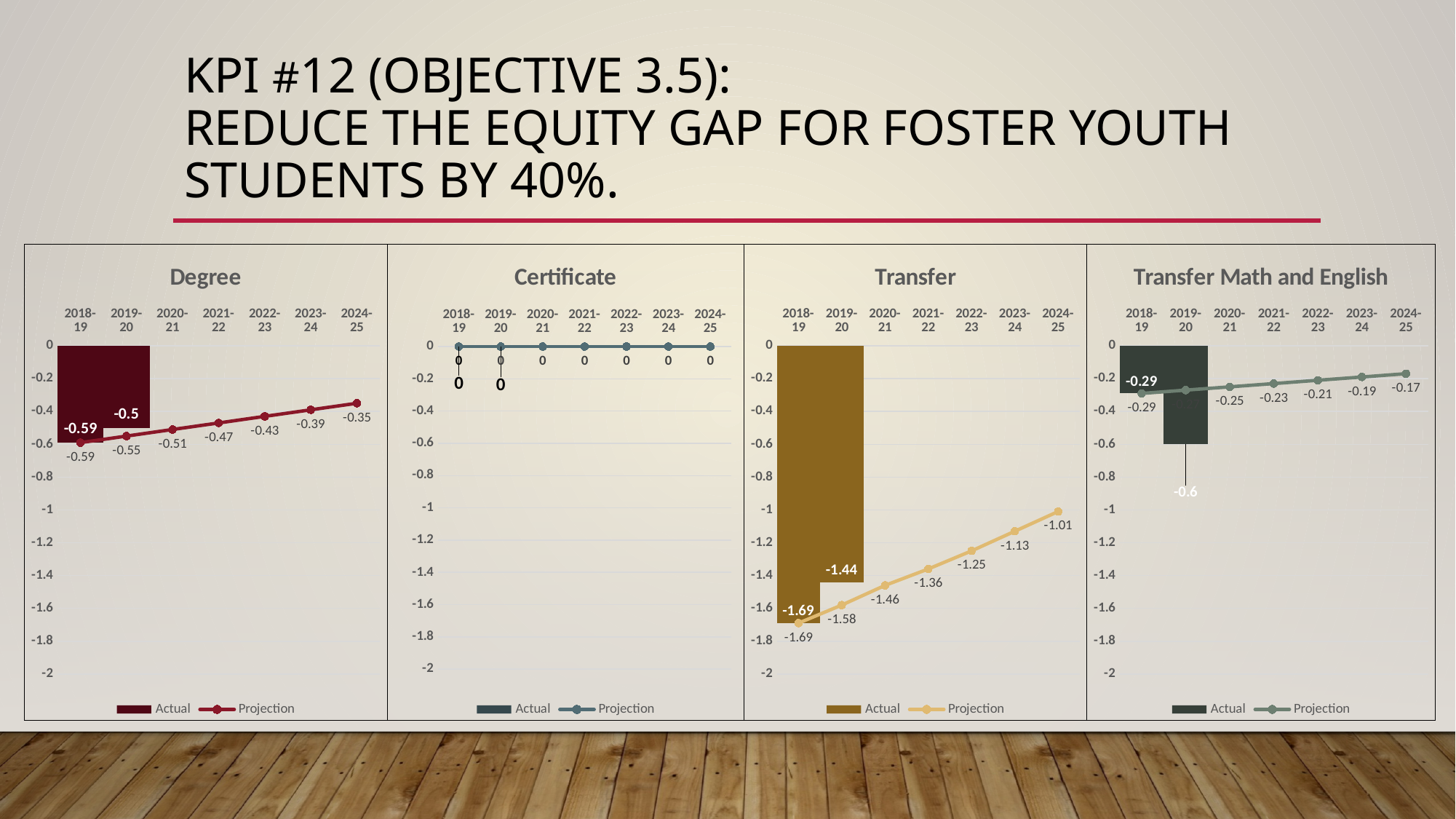
In the Degree chart, what is the Actual value for 2019-20? -0.5 In the Degree chart, what is the Projection value for 2024-25? -0.35 In the Transfer Math and English chart, is the Actual value for 2019-20 larger or smaller than the Actual value for 2018-19? smaller In the Transfer chart, what is the Actual value for 2018-19? -1.69 How many series does the legend list in the Transfer Math and English chart? 2 In the Degree chart, which year has the lowest Projection value? 2018-19 In the Certificate chart, what is the Projection value for 2022-23? 0 In the Transfer chart, what is the difference between the Actual values for 2018-19 and 2019-20? 0.25 In the Transfer chart, what is the Projection value for 2021-22? -1.36 In the Transfer chart, does the Projection line rise or fall from 2018-19 to 2024-25? rise How many years are shown on the x axis of the Degree chart? 7 In the Transfer Math and English chart, what is the Actual value for 2019-20? -0.6